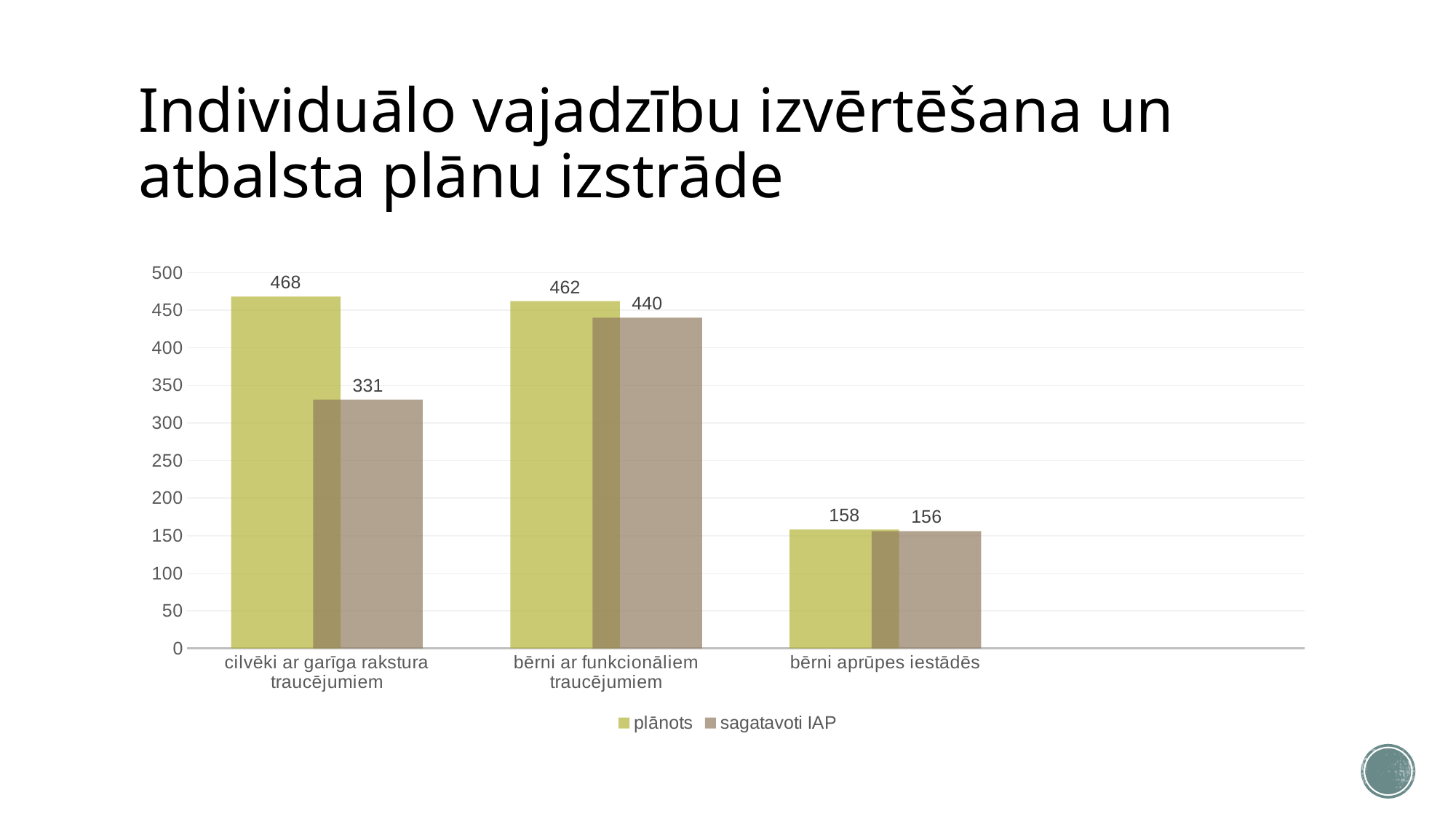
How many categories are shown on the x axis? 3 What is the 'sagatavoti IAP' value for 'bērni aprūpes iestādēs'? 156 Which category has the highest 'plānots' value? cilvēki ar garīga rakstura traucējumiem How many series does the legend list? 2 Which is larger: the 'sagatavoti IAP' value for 'cilvēki ar garīga rakstura traucējumiem' or for 'bērni ar funkcionāliem traucējumiem'? bērni ar funkcionāliem traucējumiem Which category has the lowest 'sagatavoti IAP' value? bērni aprūpes iestādēs What is the 'plānots' value for 'cilvēki ar garīga rakstura traucējumiem'? 468 What kind of chart is shown on the slide? bar chart What are the two series named in the legend? plānots and sagatavoti IAP What is the 'sagatavoti IAP' value for 'bērni ar funkcionāliem traucējumiem'? 440 What is the difference between the 'plānots' and 'sagatavoti IAP' values for 'cilvēki ar garīga rakstura traucējumiem'? 137 What is the difference between the 'plānots' and 'sagatavoti IAP' values for 'bērni ar funkcionāliem traucējumiem'? 22